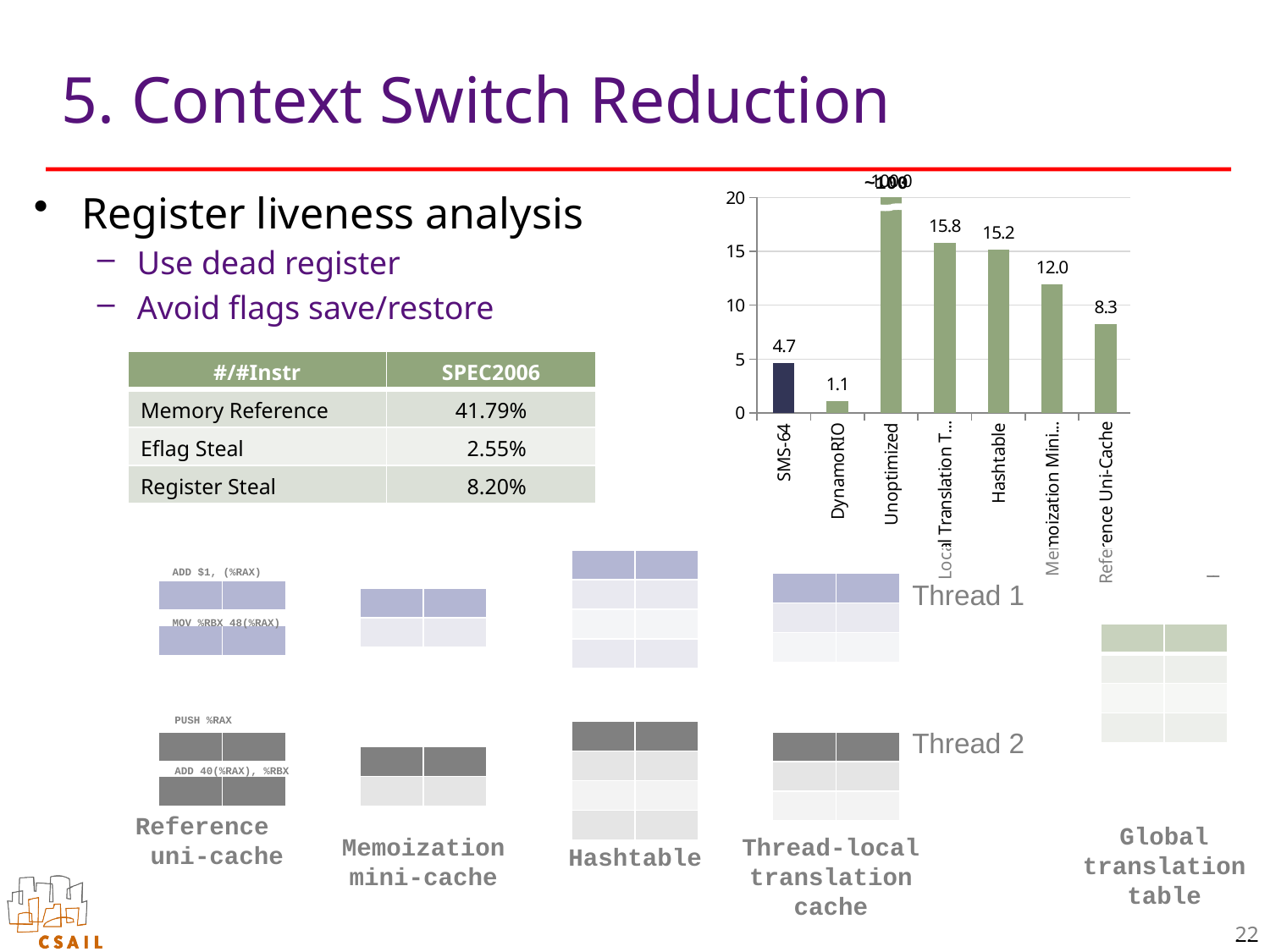
How many bars are shown in the bar chart? 7 Which is larger in the bar chart, the value for Hashtable or the value for SMS-64? Hashtable Is the value for Reference Uni-Cache in the bar chart greater or less than 10? less What is the value for DynamoRIO in the bar chart? 1.1 Which category has the lowest value in the bar chart? DynamoRIO What is the difference between the values for Hashtable and Reference Uni-Cache in the bar chart? 6.9 Which category has the highest value in the bar chart? Unoptimized What is the difference between the values for SMS-64 and DynamoRIO in the bar chart? 3.6 What is the value for Hashtable in the bar chart? 15.2 What kind of chart is shown on the slide? bar chart What is the value for Reference Uni-Cache in the bar chart? 8.3 What is the value for SMS-64 in the bar chart? 4.7